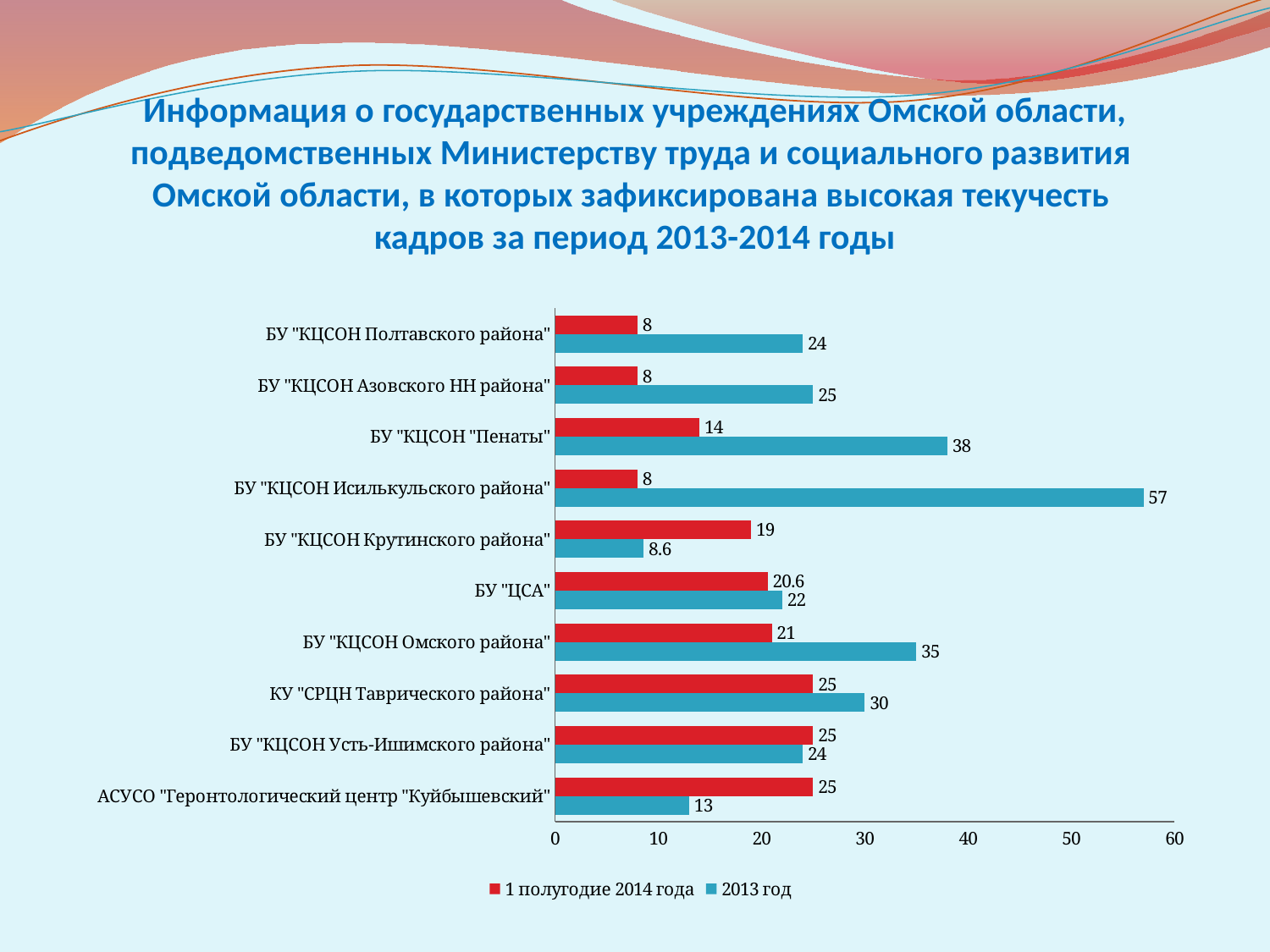
What colour are the bars for the 2013 год series? blue For АСУСО "Геронтологический центр "Куйбышевский", which series has the larger value: 1 полугодие 2014 года or 2013 год? 1 полугодие 2014 года What is the value for БУ "КЦСОН Крутинского района" in the 2013 год series? 8.6 How many series does the legend list? 2 Which institution has the lowest value in the 2013 год series? БУ "КЦСОН Крутинского района" What is the value for БУ "КЦСОН Исилькульского района" in the 2013 год series? 57 What is the value for БУ "ЦСА" in the 1 полугодие 2014 года series? 20.6 Is the 2013 год value for БУ "КЦСОН Омского района" greater or less than 30? greater How many institutions (categories) are shown in the chart? 10 Which institution has the highest value in the 2013 год series? БУ "КЦСОН Исилькульского района" What is the difference between the 2013 год and 1 полугодие 2014 года values for БУ "КЦСОН "Пенаты"? 24 What type of chart is shown on the slide? bar chart